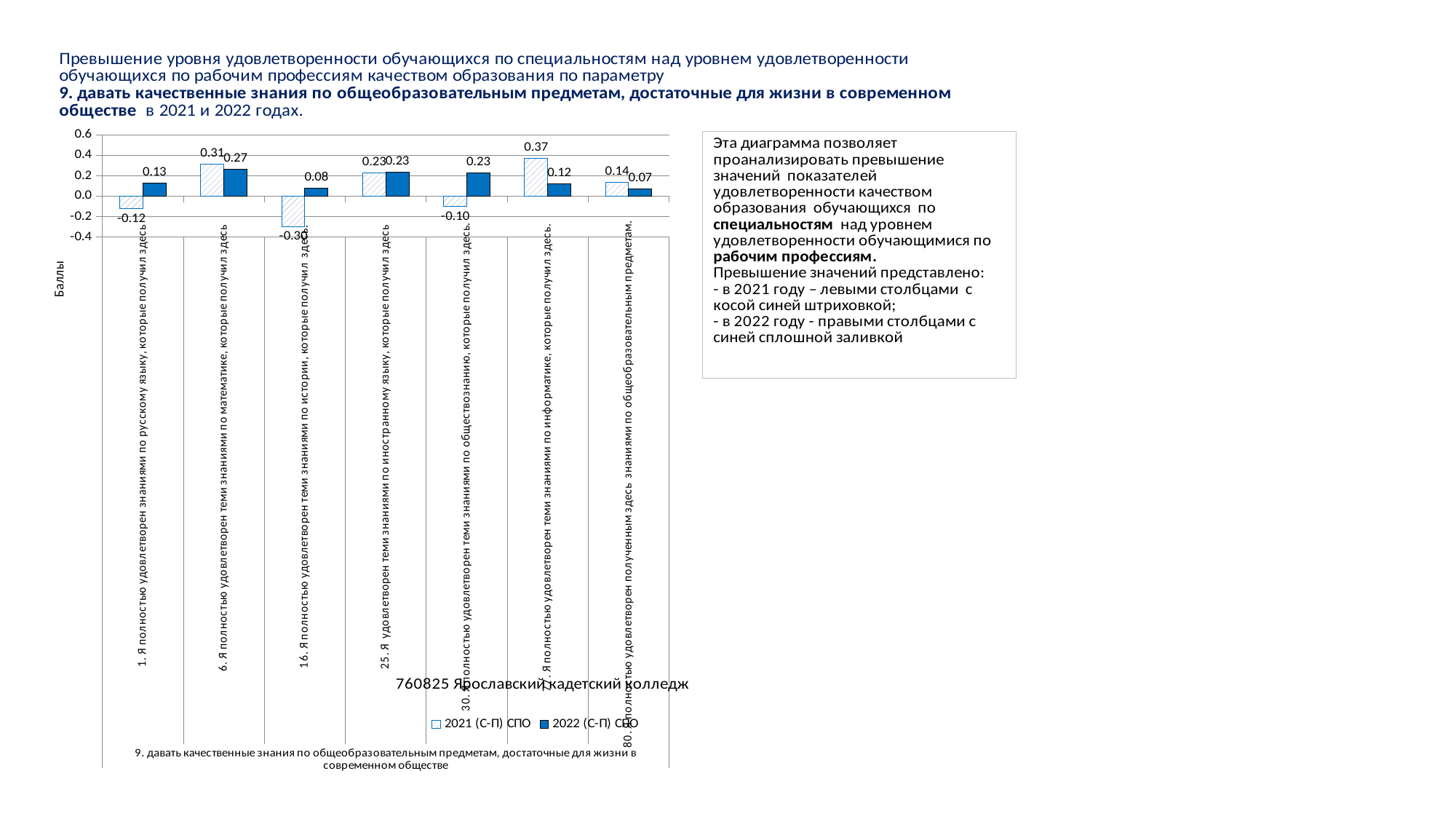
What is the 2022 (С-П) СПО value for the category about knowledge of social studies (обществознанию)? 0.23 Which category has the lowest 2021 (С-П) СПО value? 16. Я полностью удовлетворен теми знаниями по истории, которые получил здесь What is the 2021 (С-П) СПО value for the category about knowledge of mathematics (математике)? 0.31 How many series does the chart legend list? 2 What is the 2022 (С-П) СПО value for the category about knowledge of history (истории)? 0.08 How many categories are shown on the x axis of the chart? 7 For the category about knowledge of mathematics (математике), which is larger: the 2021 (С-П) СПО value or the 2022 (С-П) СПО value? 2021 (С-П) СПО What is the 2021 (С-П) СПО value for the category about knowledge of the Russian language (русскому языку)? -0.12 What is the difference between the 2021 and 2022 (С-П) СПО values for the category about knowledge of informatics (информатике)? 0.25 Which category has the highest 2021 (С-П) СПО value? Я полностью удовлетворен теми знаниями по информатике, которые получил здесь Which category has the highest 2022 (С-П) СПО value? 6. Я полностью удовлетворен теми знаниями по математике, которые получил здесь What type of chart is shown on the slide? Bar chart